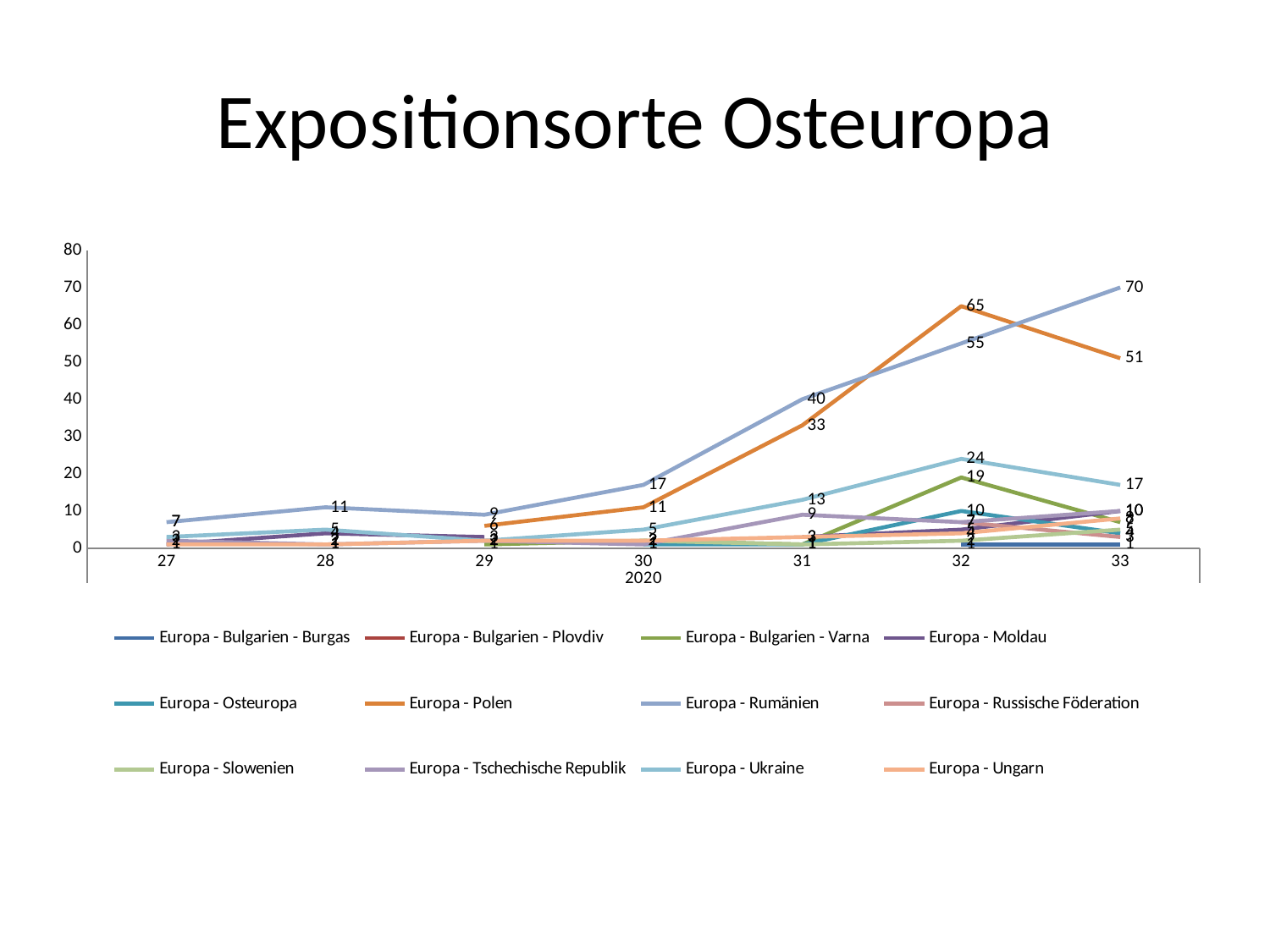
What is the value for Europa - Polen in week 32? 65 What is the difference between Europa - Rumänien and Europa - Polen in week 33? 19 What is the value for Europa - Rumänien in week 31? 40 Which series has the highest value in week 33? Europa - Rumänien Which series has the highest value in week 32? Europa - Polen How many series does the legend list? 12 What is the value for Europa - Ukraine in week 32? 24 What kind of chart is shown on the slide? line chart How many calendar weeks are plotted along the x axis? 7 What is the value for Europa - Rumänien in week 33? 70 Which is larger in week 32, Europa - Polen or Europa - Rumänien? Europa - Polen Does the value for Europa - Rumänien rise or fall from week 30 to week 33? rise